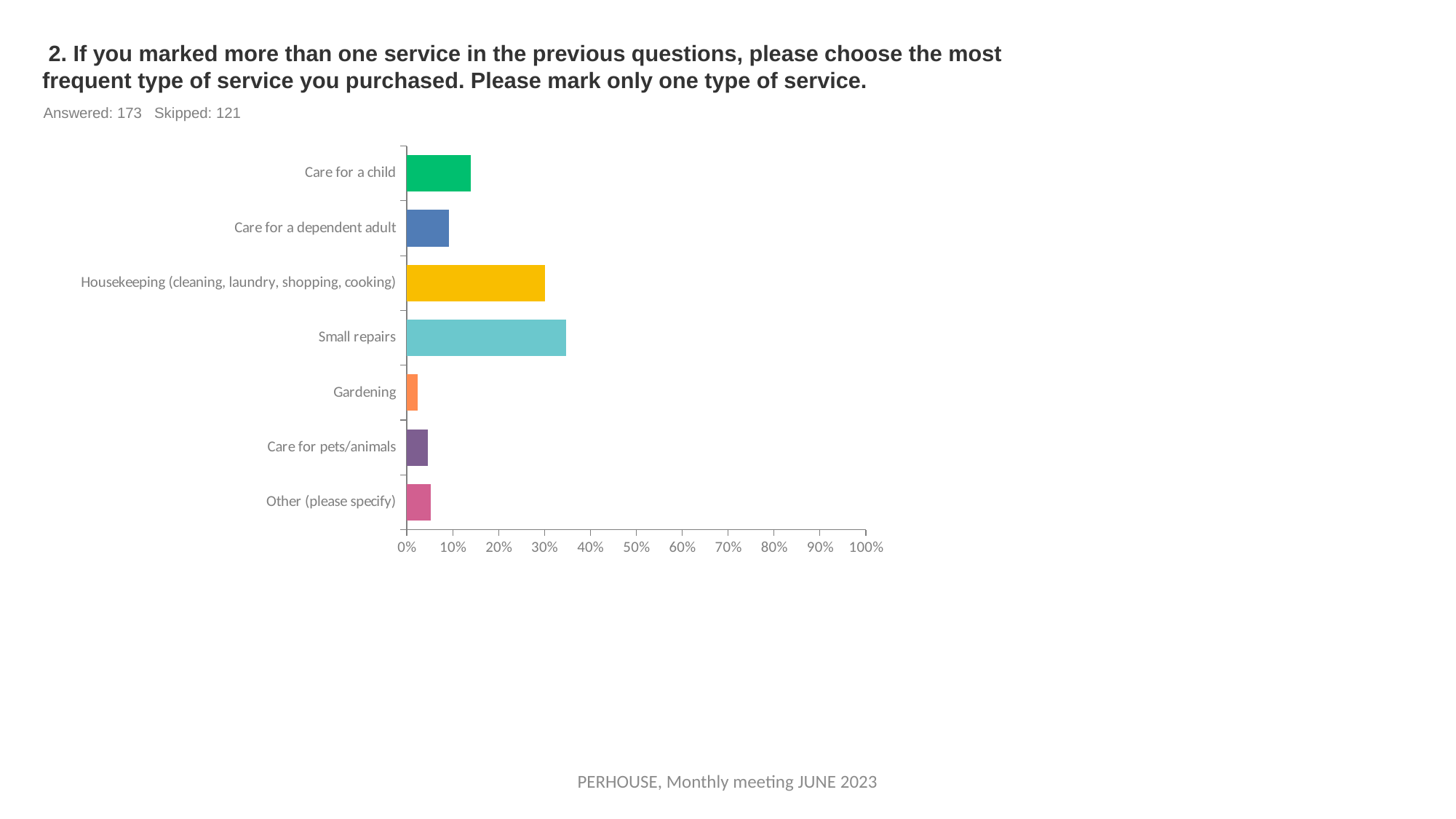
Which service category has the highest value in the chart? Small repairs How many service categories are plotted in the chart? 7 Which service category has the lowest value in the chart? Gardening Is the value for Care for a child greater or less than 10%? greater Which is larger, the value for Care for a child or the value for Care for a dependent adult? Care for a child Which is larger, the value for Housekeeping (cleaning, laundry, shopping, cooking) or the value for Care for pets/animals? Housekeeping (cleaning, laundry, shopping, cooking) What kind of chart is shown on the slide? bar chart Is the value for Housekeeping (cleaning, laundry, shopping, cooking) greater or less than 20%? greater How many respondents answered this question according to the slide? 173 Is the value for Other (please specify) greater or less than 10%? less